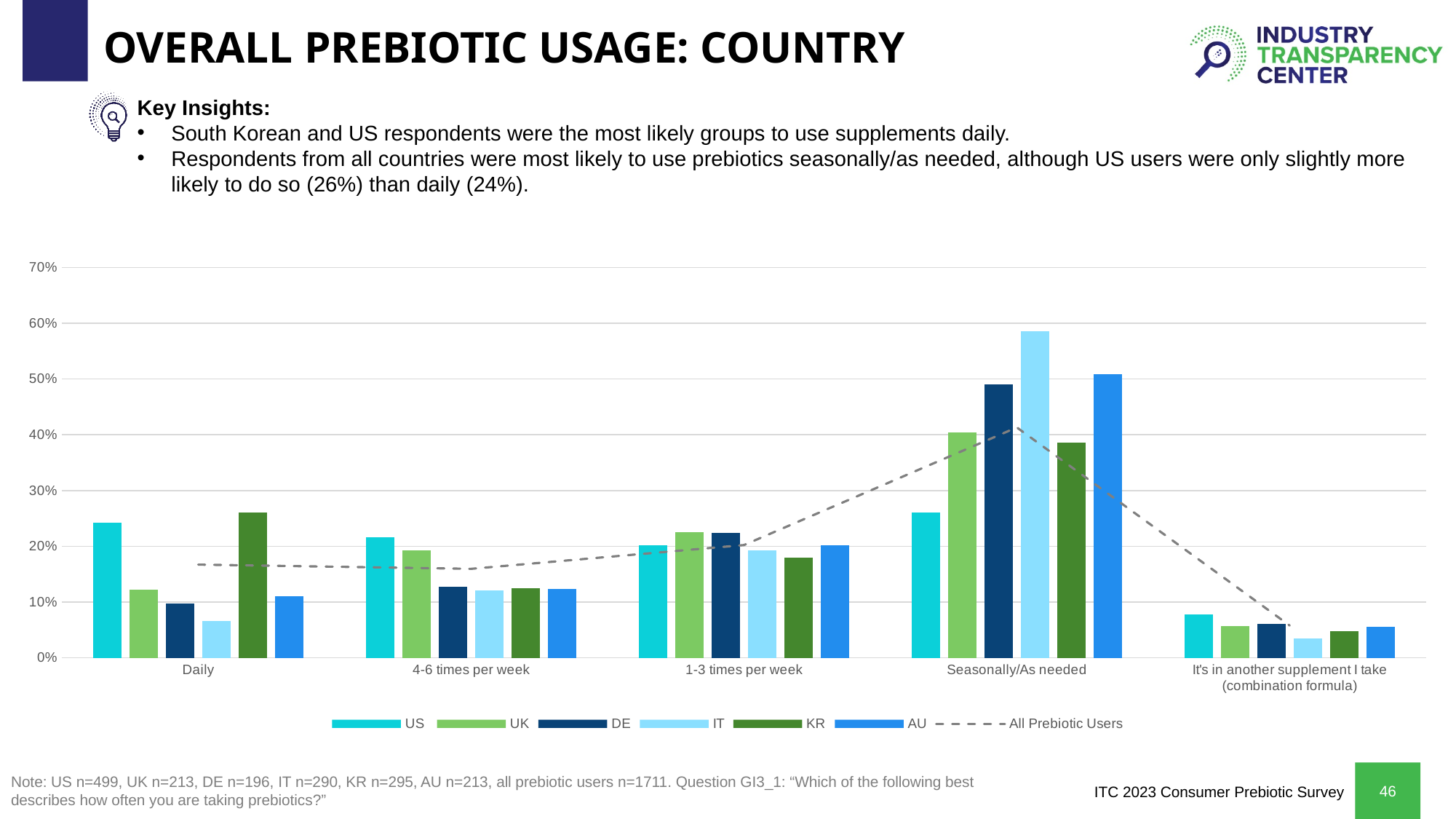
Is the value for IT in the Seasonally/As needed category greater or less than 50%? greater How many frequency categories are shown along the x axis? 5 Does the All Prebiotic Users dashed line rise or fall from Seasonally/As needed to It's in another supplement I take? fall In the Daily category, which is larger: the KR bar or the AU bar? KR Which country has the highest bar in the Seasonally/As needed category? IT Which country has the highest bar in the Daily category? KR Is the value for IT in the Daily category greater or less than 10%? less Which country has the lowest bar in the Daily category? IT What type of chart is shown on the slide? Bar chart (with a dashed line series) Is the value for KR in the Daily category greater or less than 20%? greater Which country has the highest bar in the 4-6 times per week category? US How many series does the legend list? 7